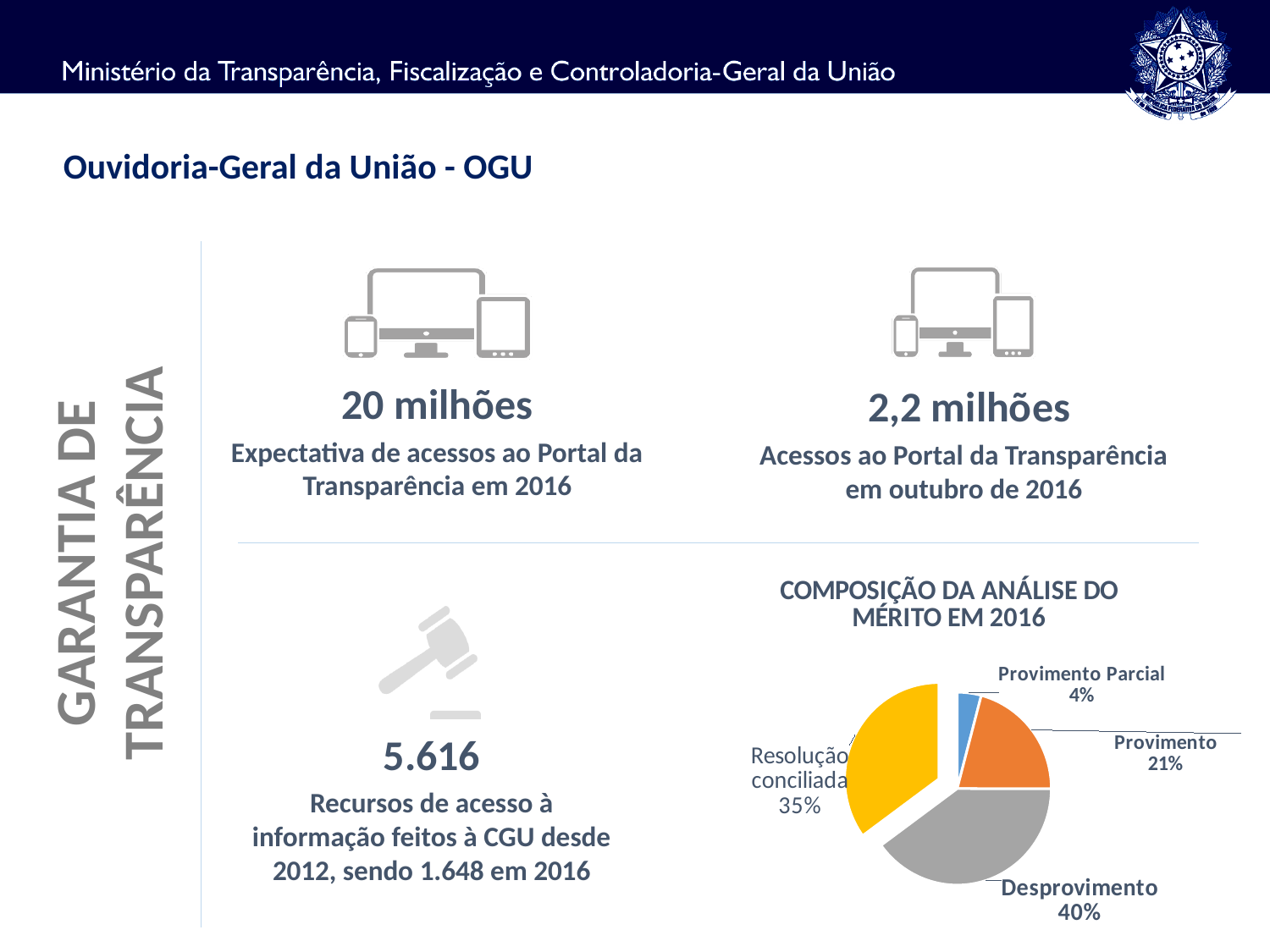
Which category has the largest slice in the pie chart? Desprovimento What kind of chart is shown under the title "COMPOSIÇÃO DA ANÁLISE DO MÉRITO EM 2016"? Pie chart What is the share for Desprovimento in the pie chart? 40% What is the difference in percentage points between Provimento and Provimento Parcial in the pie chart? 17 What is the title of the pie chart on the slide? COMPOSIÇÃO DA ANÁLISE DO MÉRITO EM 2016 Which is larger in the pie chart, Provimento or Resolução conciliada? Resolução conciliada What is the share for Provimento Parcial in the pie chart? 4% Which category has the smallest slice in the pie chart? Provimento Parcial What is the share for Provimento in the pie chart? 21% What is the difference in percentage points between Desprovimento and Resolução conciliada in the pie chart? 5 What is the share for Resolução conciliada in the pie chart? 35% How many slices does the pie chart have? 4